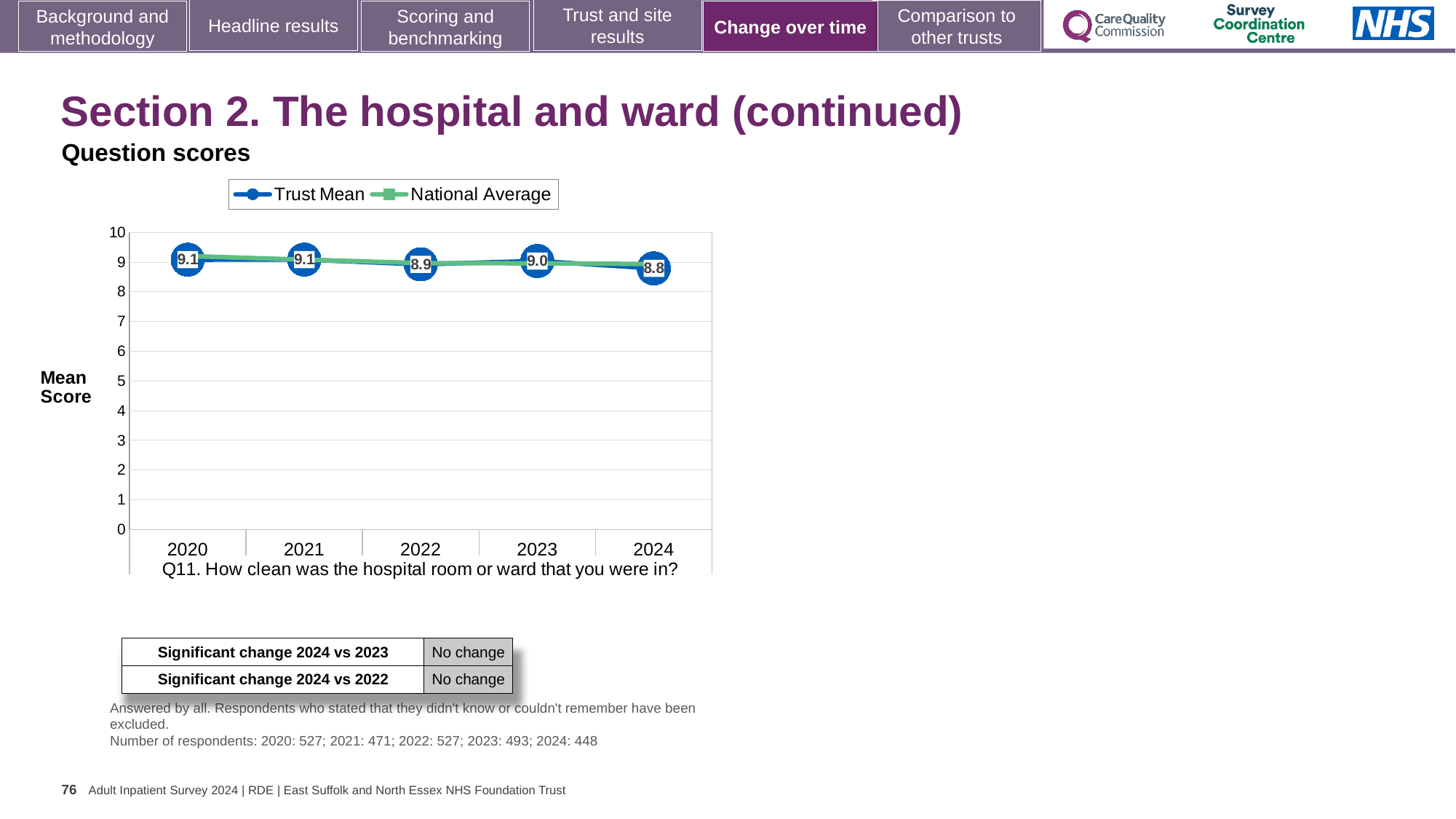
What is the difference between the Trust Mean in 2020 and in 2024? 0.3 What is the Trust Mean value for 2022? 8.9 In which year is the Trust Mean lowest? 2024 What kind of chart is shown on the slide? Line chart How many series does the chart legend list? 2 Is the National Average value for 2024 greater or less than 8? greater What is the Trust Mean value for 2020? 9.1 How many years are shown on the x axis of the chart? 5 What is the Trust Mean value for 2023? 9.0 What is the Trust Mean value for 2024? 8.8 Which is larger, the Trust Mean for 2022 or for 2023? 2023 Does the Trust Mean rise or fall overall from 2020 to 2024? Fall